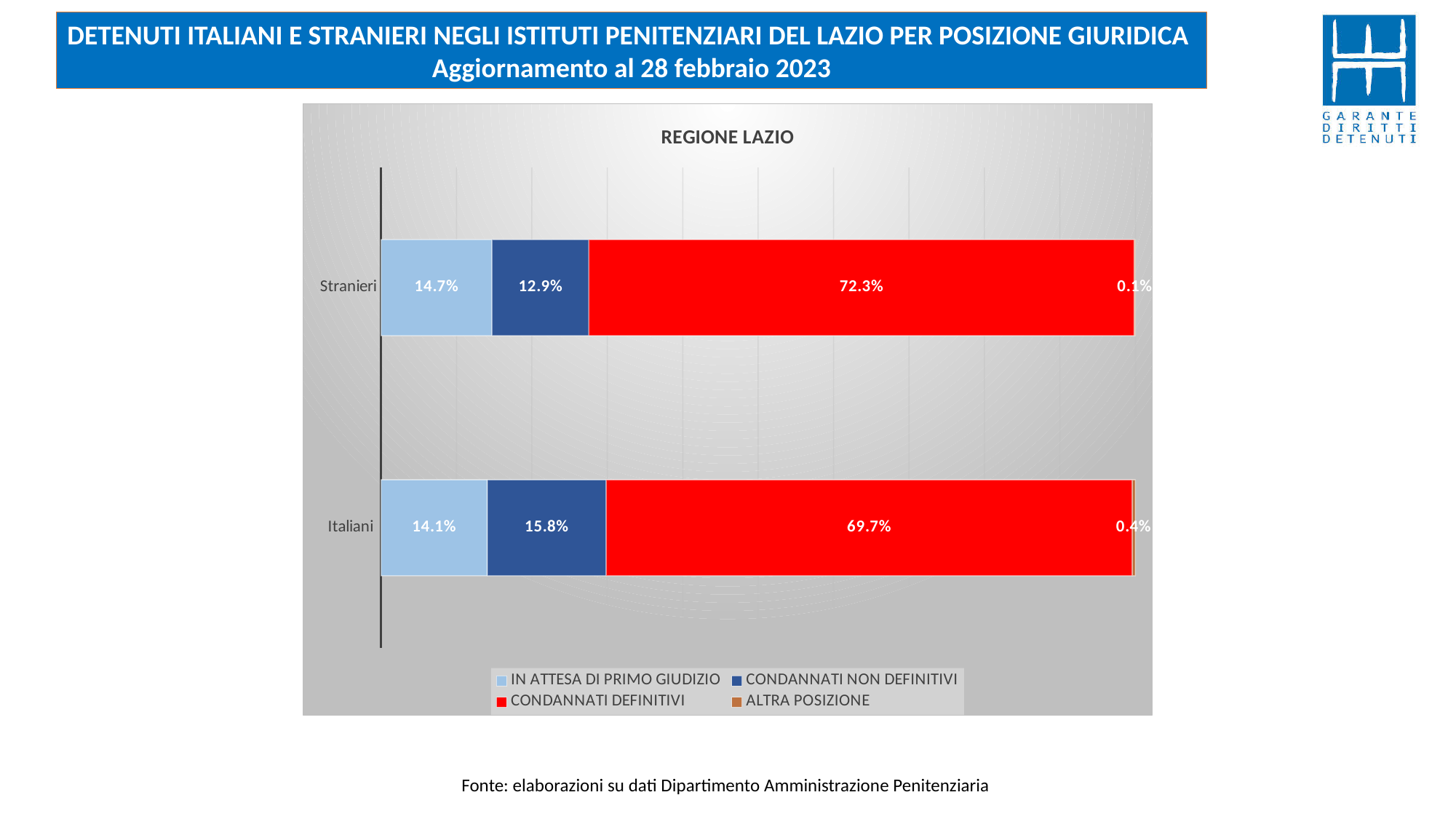
What is the value for IN ATTESA DI PRIMO GIUDIZIO for Italiani? 14.1% What kind of chart is shown on the slide? Stacked bar chart What is the value for CONDANNATI DEFINITIVI for Stranieri? 72.3% How many series does the legend list? 4 What is the difference between the CONDANNATI NON DEFINITIVI values for Italiani and Stranieri? 2.9% What is the value for ALTRA POSIZIONE for Italiani? 0.4% What is the value for CONDANNATI NON DEFINITIVI for Stranieri? 12.9% Which category has the higher value for CONDANNATI NON DEFINITIVI, Stranieri or Italiani? Italiani Which category has the higher value for CONDANNATI DEFINITIVI, Stranieri or Italiani? Stranieri How many categories are shown on the chart? 2 What is the difference between the CONDANNATI DEFINITIVI values for Stranieri and Italiani? 2.6% What is the title of the chart? REGIONE LAZIO